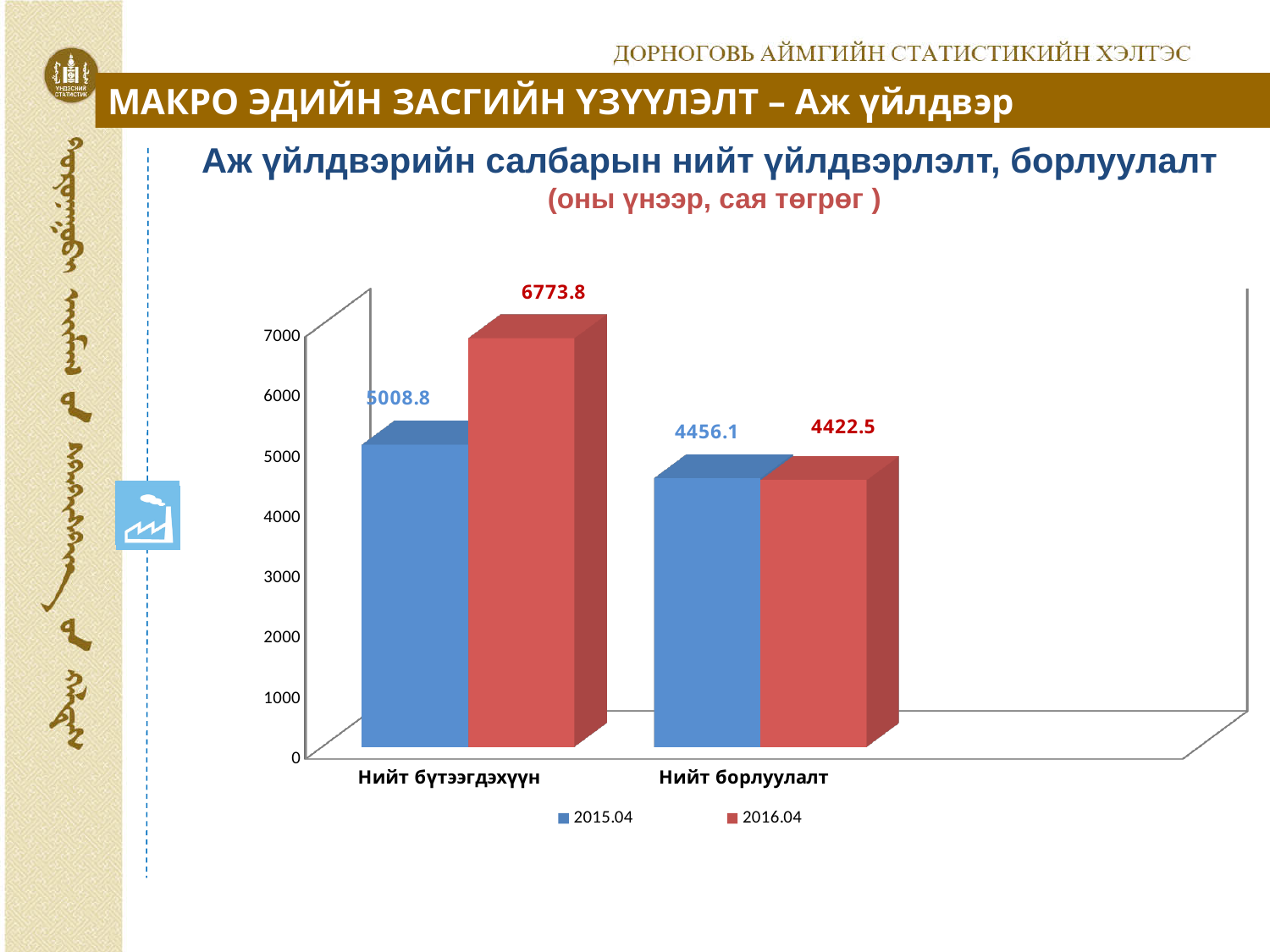
Is the 2016.04 value for Нийт бүтээгдэхүүн greater or less than 6000? greater What is the difference between the 2016.04 and 2015.04 values for Нийт бүтээгдэхүүн? 1765.0 How many series does the legend list? 2 What is the value for Нийт борлуулалт in the 2016.04 series? 4422.5 How many categories are shown on the x axis? 2 Which is larger: the 2015.04 value for Нийт бүтээгдэхүүн or the 2015.04 value for Нийт борлуулалт? Нийт бүтээгдэхүүн What is the value for Нийт бүтээгдэхүүн in the 2015.04 series? 5008.8 What is the value for Нийт бүтээгдэхүүн in the 2016.04 series? 6773.8 What is the value for Нийт борлуулалт in the 2015.04 series? 4456.1 What is the difference between the 2015.04 and 2016.04 values for Нийт борлуулалт? 33.6 Which bar has the highest value on the chart? Нийт бүтээгдэхүүн, 2016.04 What kind of chart is shown on the slide? bar chart